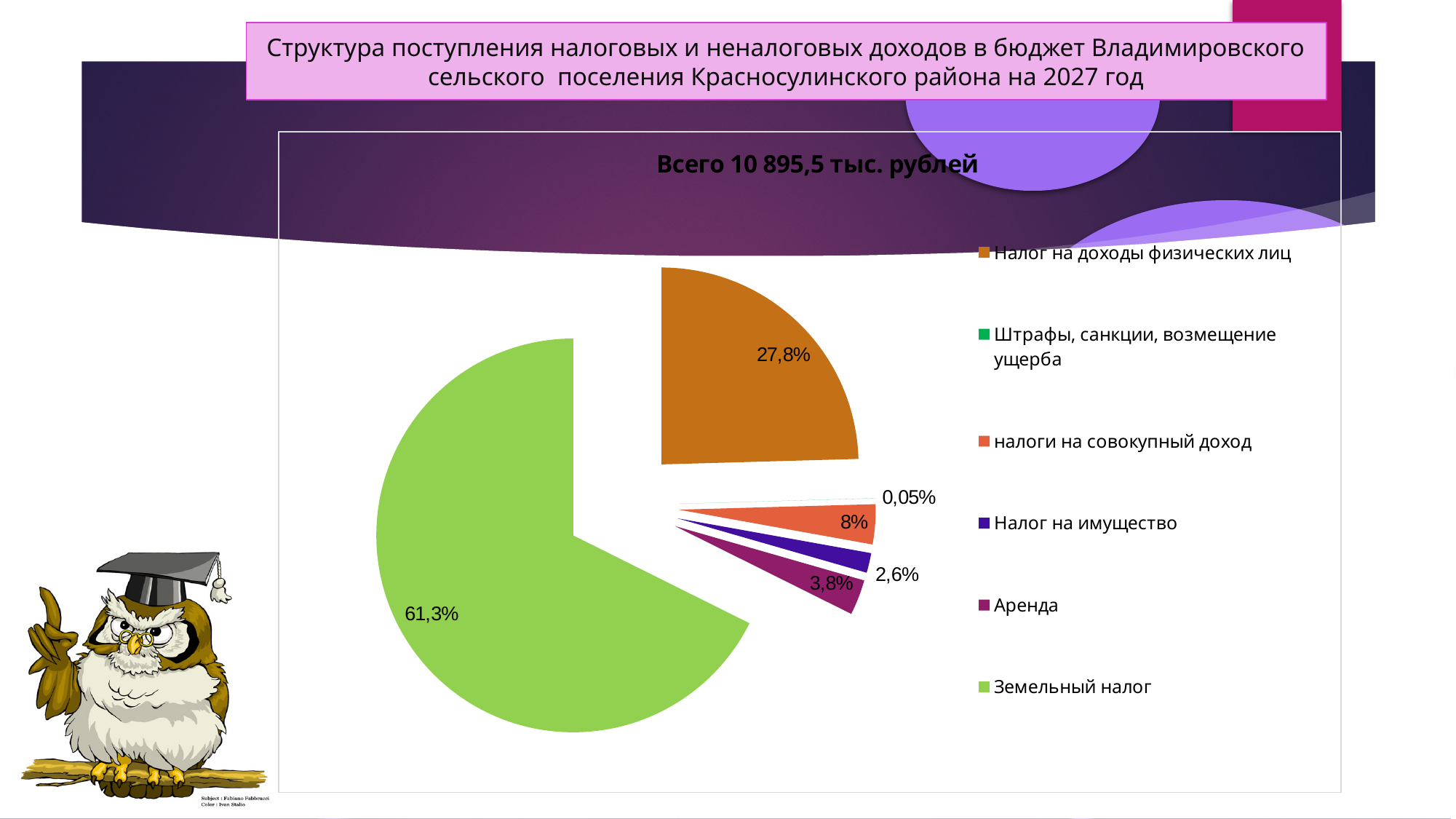
What kind of chart is shown on the slide? pie chart How many categories does the legend list? 6 What total amount is stated in the chart title? 10 895,5 тыс. рублей What is the value shown for Штрафы, санкции, возмещение ущерба? 0,05% What is the value shown for Налог на имущество? 2,6% Which category has the largest slice of the pie? Земельный налог Which is larger, Аренда or Налог на имущество? Аренда What share of the pie does Налог на доходы физических лиц have? 27,8% What is the value shown for налоги на совокупный доход? 8% Which category has the smallest slice of the pie? Штрафы, санкции, возмещение ущерба What is the value shown for Аренда? 3,8% What share of the pie does Земельный налог have? 61,3%